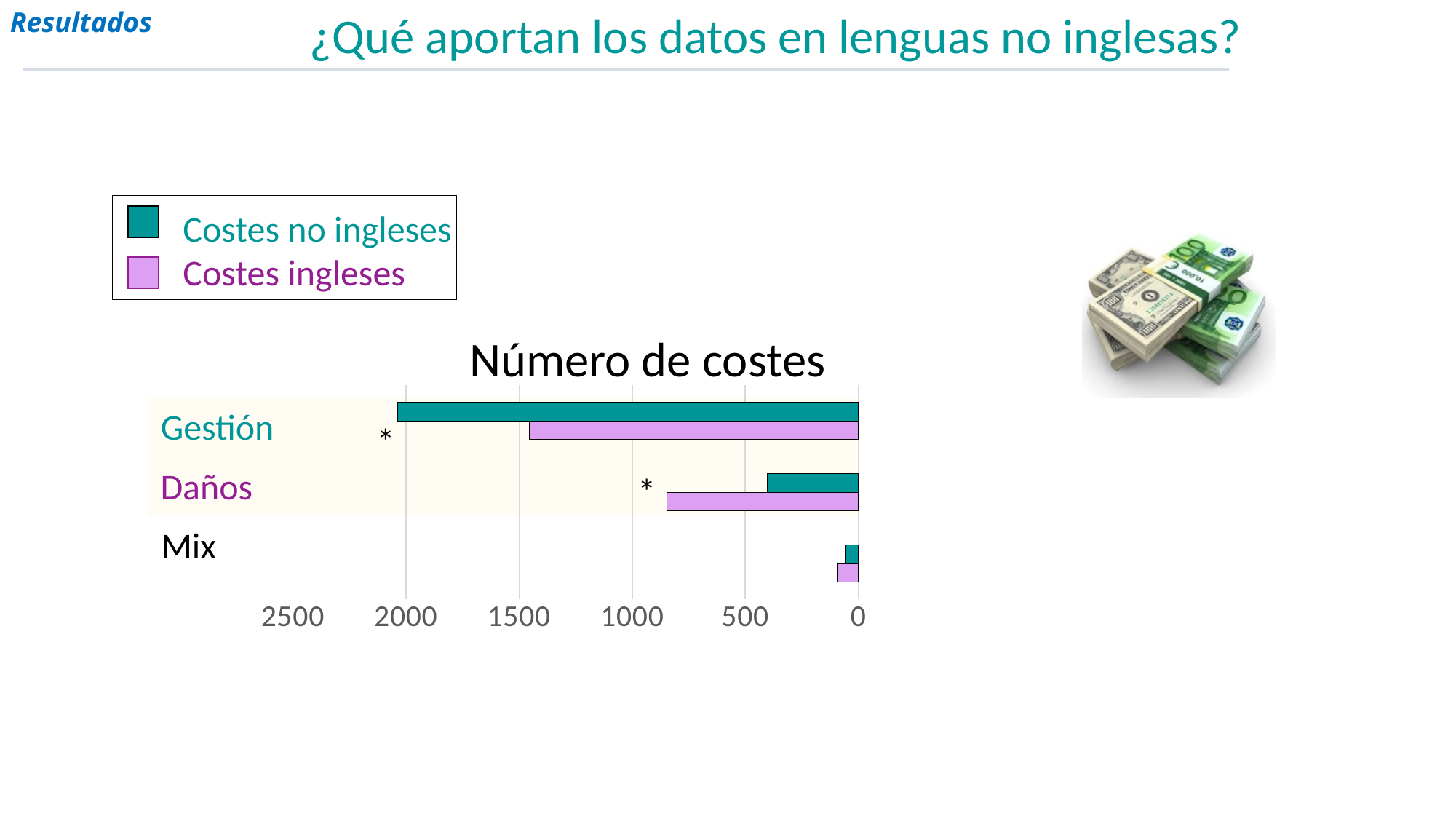
Is the value for Costes no ingleses in Daños greater or less than 500? less For Daños, which is larger: Costes no ingleses or Costes ingleses? Costes ingleses Is the value for Costes no ingleses in Gestión greater or less than 1500? greater Is the value for Costes ingleses in Daños greater or less than 1000? less Which category has the highest value for Costes no ingleses? Gestión How many categories are shown on the chart? 3 What is the title of the chart? Número de costes How many series does the legend list? 2 What type of chart is shown on the slide? bar chart Which category has the lowest value for Costes ingleses? Mix Which legend entry is shown in teal? Costes no ingleses For Gestión, which is larger: Costes no ingleses or Costes ingleses? Costes no ingleses